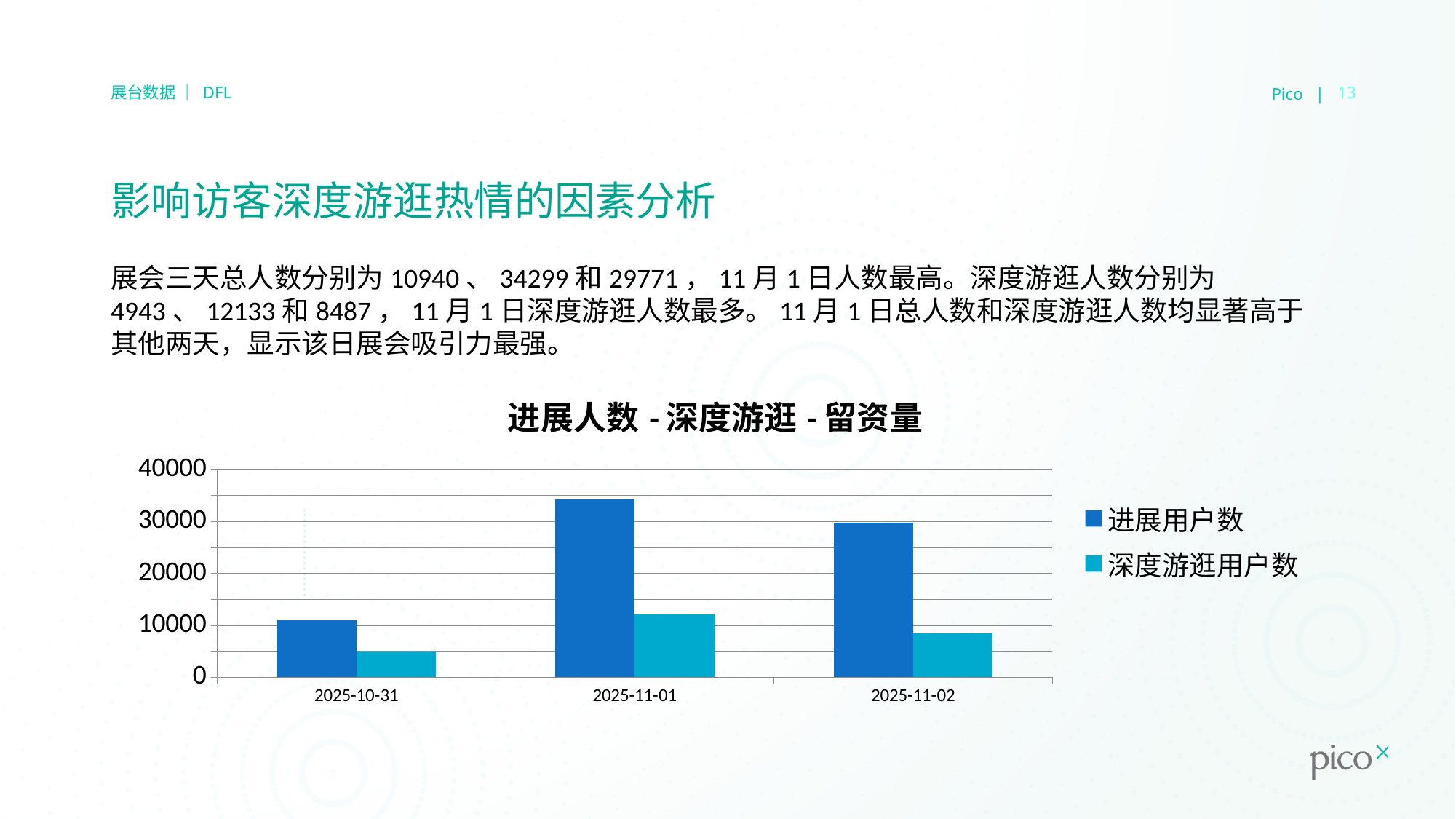
Which is larger: 进展用户数 on 2025-11-02 or 进展用户数 on 2025-10-31? 2025-11-02 According to the slide, what is the 深度游逛用户数 value for 2025-10-31? 4943 What kind of chart is shown on the slide? bar chart What is the title of the chart? 进展人数 - 深度游逛 - 留资量 Is the 进展用户数 value for 2025-10-31 greater or less than 20000? less Which date has the highest 进展用户数? 2025-11-01 How many series does the chart legend list? 2 Is the 深度游逛用户数 value for 2025-11-02 greater or less than 10000? less How many dates are shown on the x axis of the chart? 3 Which date has the lowest 深度游逛用户数? 2025-10-31 Is the 进展用户数 value for 2025-11-01 greater or less than 30000? greater According to the slide, what is the 进展用户数 value for 2025-11-01? 34299